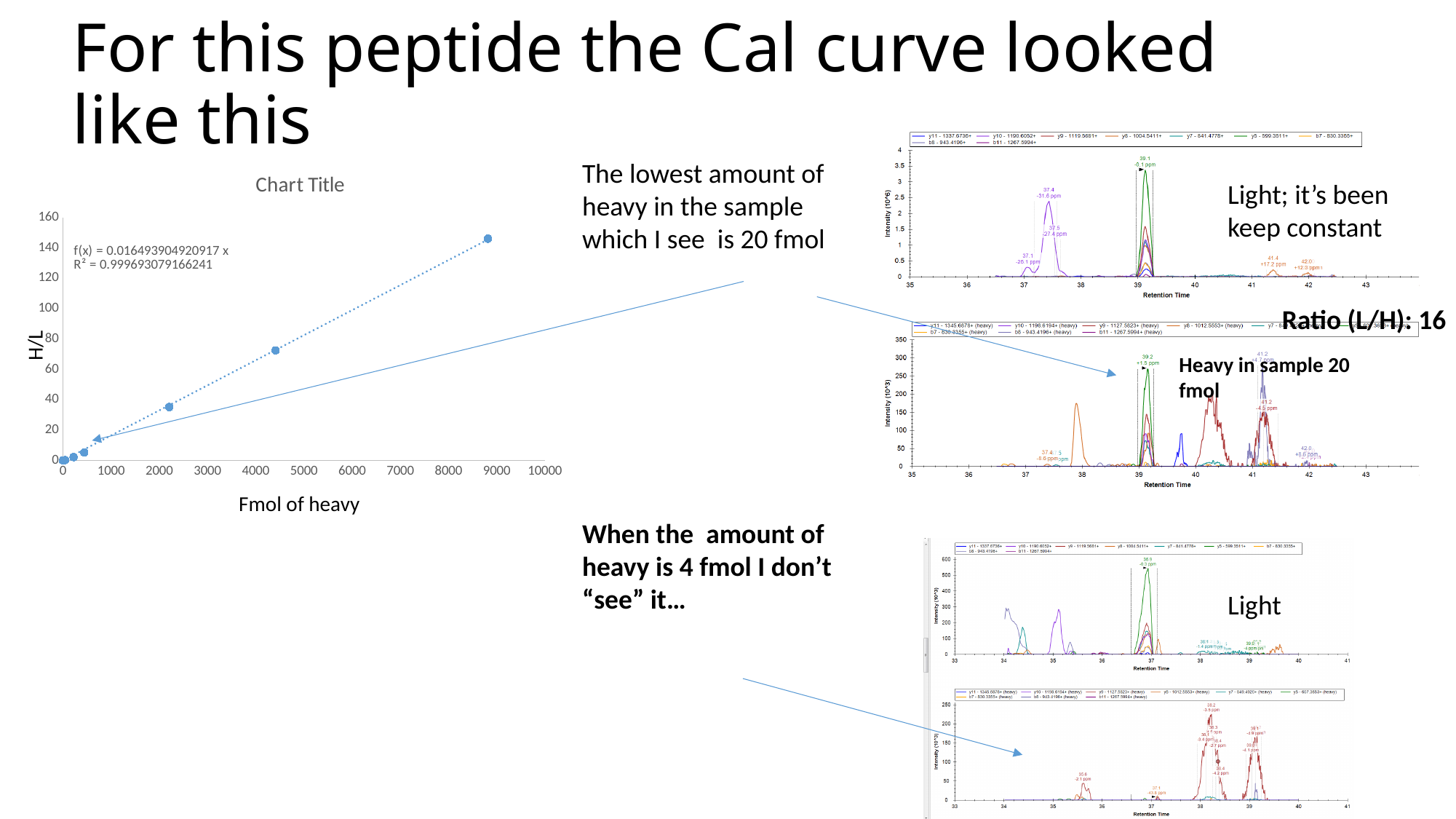
In the scatter chart on the left, what is the highest tick value shown on the x axis? 10000 In the scatter chart on the left, is the H/L value of the point near 2200 fmol greater or less than 20? greater In the scatter chart on the left, which point has the higher H/L: the one near 4400 fmol or the one near 9000 fmol? the one near 9000 fmol What is the x-axis label of the scatter chart on the left? Fmol of heavy In the scatter chart on the left, what is the highest tick value shown on the y axis? 160 In the scatter chart on the left, is the H/L value of the point near 4400 fmol greater or less than 60? greater In the scatter chart on the left, what R² value is printed on the chart? 0.999693079166241 What kind of chart is the chart titled "Chart Title" on the left of the slide? scatter chart What is the title shown above the scatter chart on the left? Chart Title In the scatter chart on the left, is the H/L value of the point near 9000 fmol greater or less than 120? greater In the scatter chart on the left, do the H/L values rise or fall as Fmol of heavy increases? rise In the scatter chart on the left, what trendline equation is printed on the chart? f(x) = 0.016493904920917 x